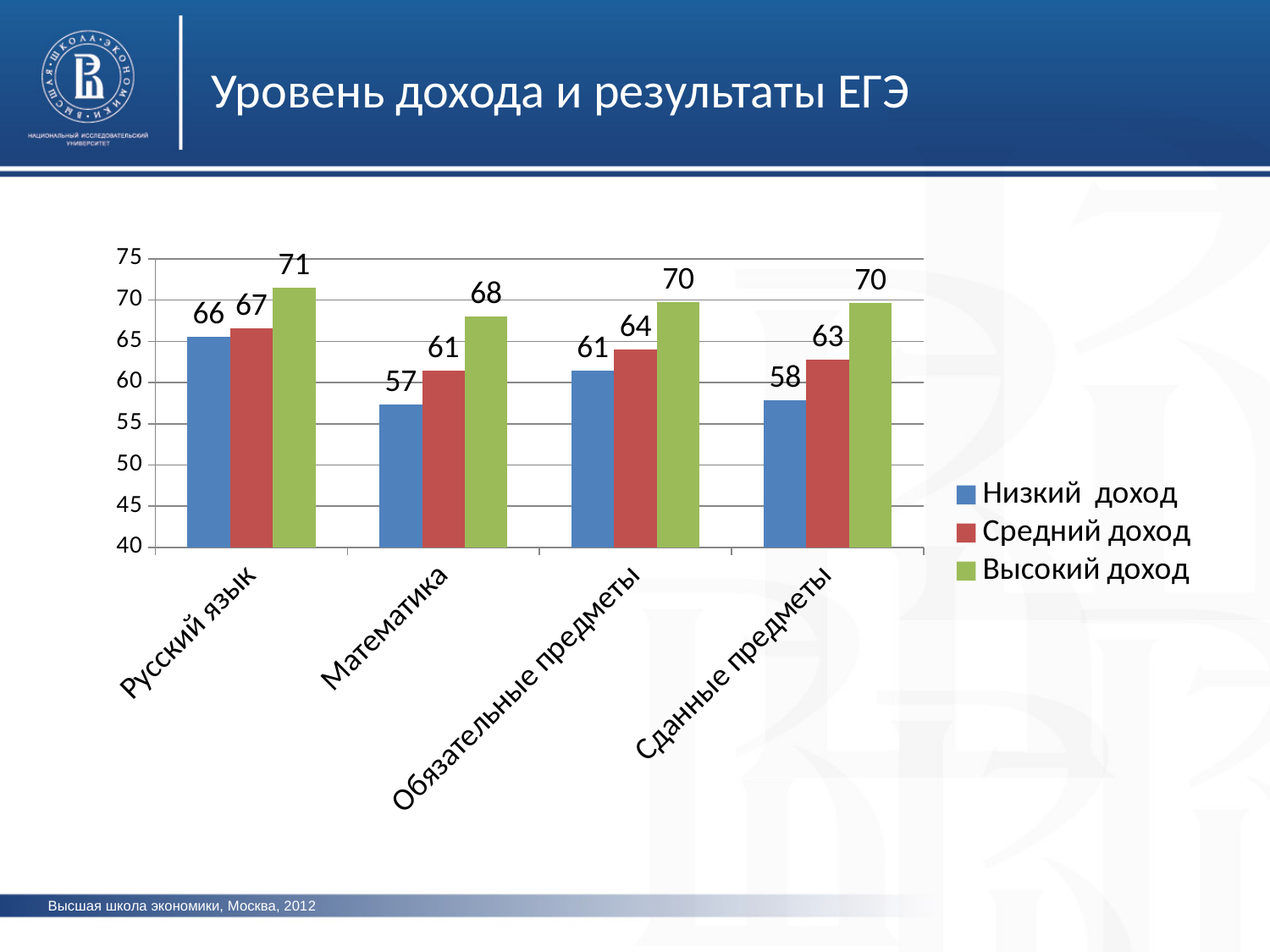
Which category has the lowest value for Низкий доход? Математика What is the value for Высокий доход in the Математика category? 68 What kind of chart is shown on the slide? bar chart Which series is shown in green in the legend? Высокий доход What is the value for Низкий доход in the Русский язык category? 66 How many categories are shown on the x axis? 4 Is the value for Низкий доход in the Сданные предметы category greater or less than 60? less What is the value for Средний доход in the Сданные предметы category? 63 Which category has the highest value for Высокий доход? Русский язык Which is larger: the Средний доход value for Обязательные предметы or the Средний доход value for Сданные предметы? Обязательные предметы How many series does the legend list? 3 What is the difference between the Высокий доход and Низкий доход values in the Математика category? 11